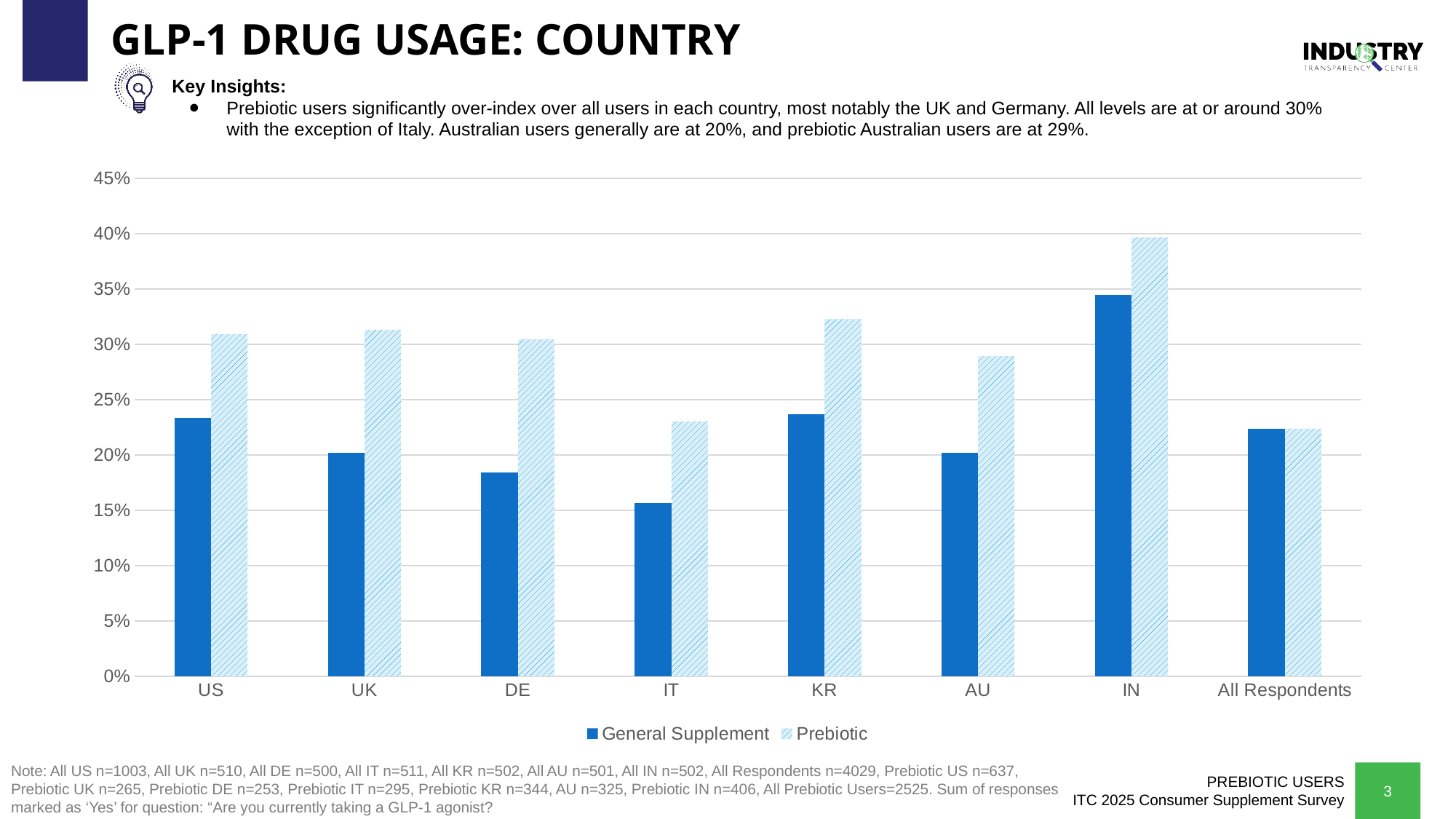
Which country has the lowest General Supplement value? IT What kind of chart is shown on the slide? Bar chart What are the two series named in the legend? General Supplement and Prebiotic Which country has the highest Prebiotic value? IN Which is larger: the General Supplement value for US or the General Supplement value for UK? US Is the Prebiotic value for IN greater or less than 35%? greater How many series does the legend list? 2 Is the General Supplement value for IN greater or less than 30%? greater Is the General Supplement value for IT greater or less than 20%? less How many categories are shown on the x axis? 8